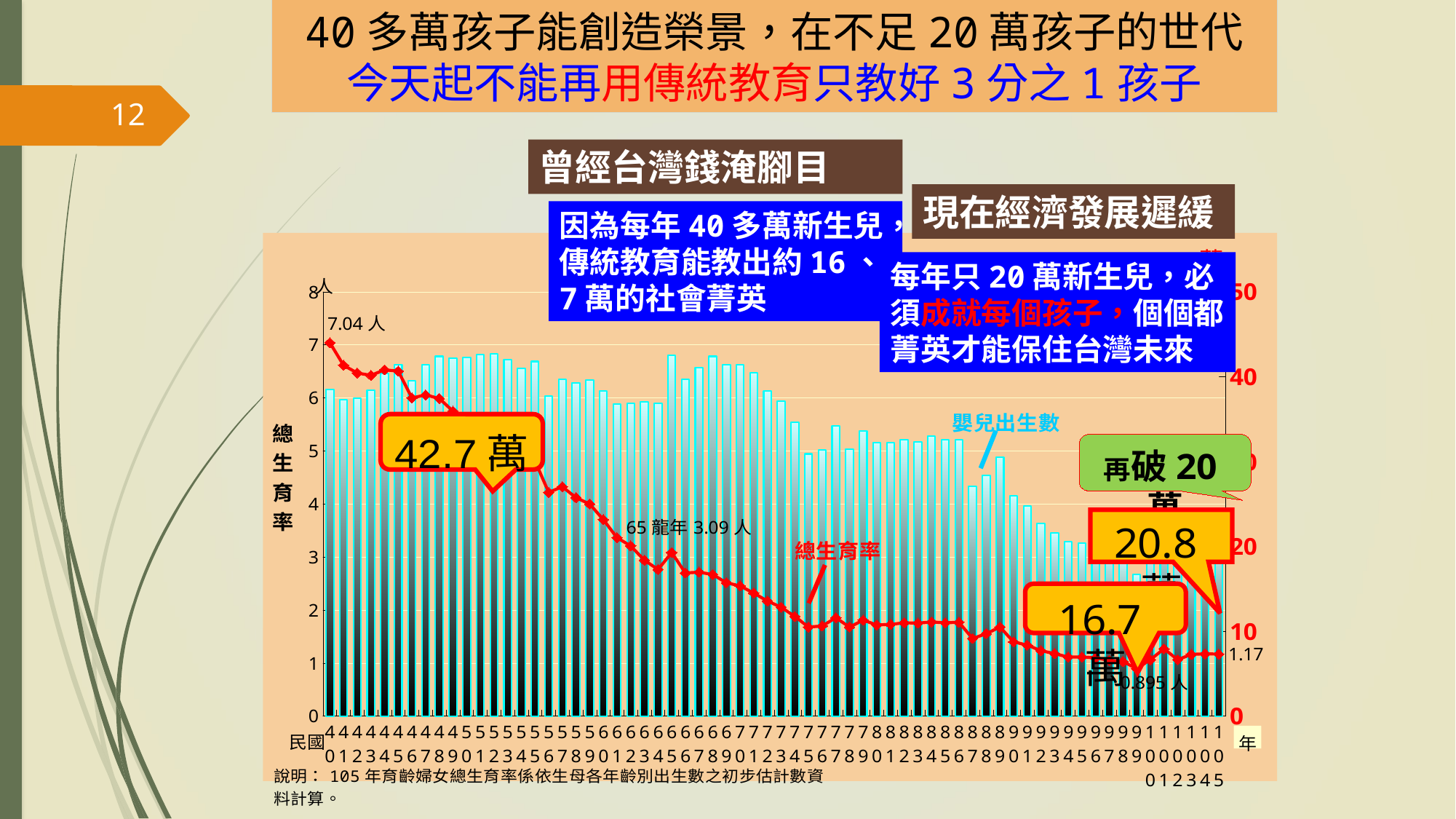
How many data series are plotted on the chart? 2 What is the difference between the labelled fertility rate of 7.04 人 in 民國 40 and the 3.09 人 of 65 龍年? 3.95 人 What are the names of the two series labelled on the chart? 嬰兒出生數 and 總生育率 Does the total fertility rate line generally rise or fall from 民國 40 to 民國 105? Fall What is the total fertility rate (總生育率) labelled at the start of the series, in 民國 40? 7.04 人 What is the lowest total fertility rate value labelled on the line? 0.895 人 What kind of chart is shown on the slide? A combined bar and line chart What is the title of the left vertical axis? 總生育率 Which is larger, the total fertility rate in 民國 40 or in 民國 105? 民國 40 What total fertility rate is labelled for 65 龍年? 3.09 人 What peak number of infant births is shown in the callout over the early bars? 42.7 萬 What total fertility rate is labelled at the right end of the line, in 民國 105? 1.17